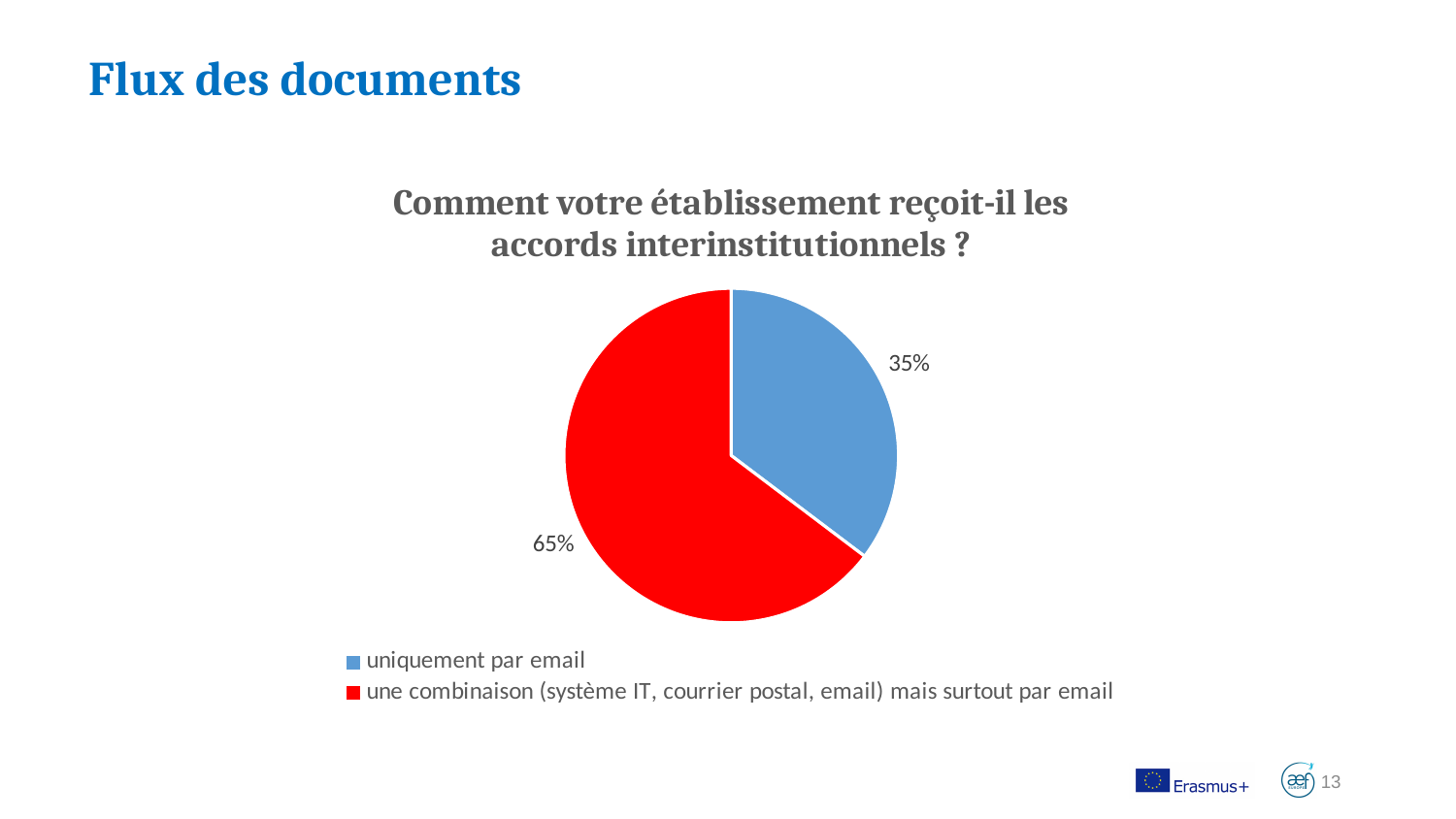
Which is larger: the slice for 'uniquement par email' or the slice for 'une combinaison ... mais surtout par email'? une combinaison (système IT, courrier postal, email) mais surtout par email Which category has the largest slice of the pie? une combinaison (système IT, courrier postal, email) mais surtout par email What colour is the slice for 'uniquement par email'? blue Which category has the smallest slice of the pie? uniquement par email How many slices does the pie chart have? 2 What is the difference in percentage points between the two slices? 30 What share of the pie is 'uniquement par email'? 35% How many entries does the legend list? 2 What share of the pie is 'une combinaison (système IT, courrier postal, email) mais surtout par email'? 65% What kind of chart is shown on the slide? pie chart What is the title of the chart? Comment votre établissement reçoit-il les accords interinstitutionnels ?